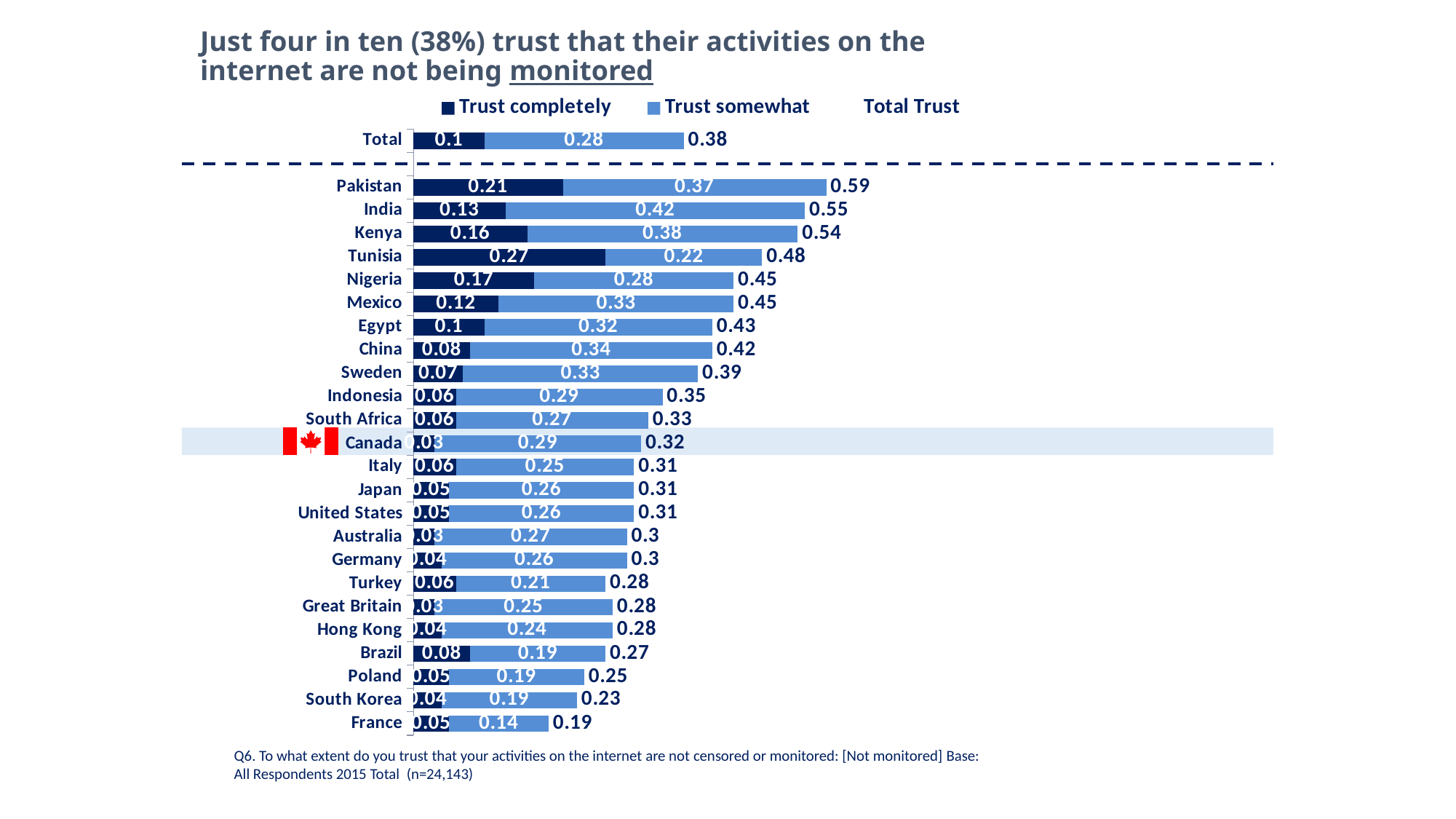
What is the Total Trust value for Pakistan? 0.59 What type of chart is shown on the slide? Stacked bar chart Which country has the lowest Total Trust value? France Which country has the highest Trust completely value? Tunisia What is the total of the stacked bar for Kenya (Trust completely plus Trust somewhat)? 0.54 What is the Trust somewhat value for Canada? 0.29 What is the difference between the Total Trust values for Pakistan and France? 0.4 Which country has the highest Total Trust value? Pakistan What is the Trust completely value for Tunisia? 0.27 Which has a larger Trust somewhat value, India or Kenya? India How many countries are listed below the dashed line in the chart? 24 What is the Total Trust value for the Total row? 0.38